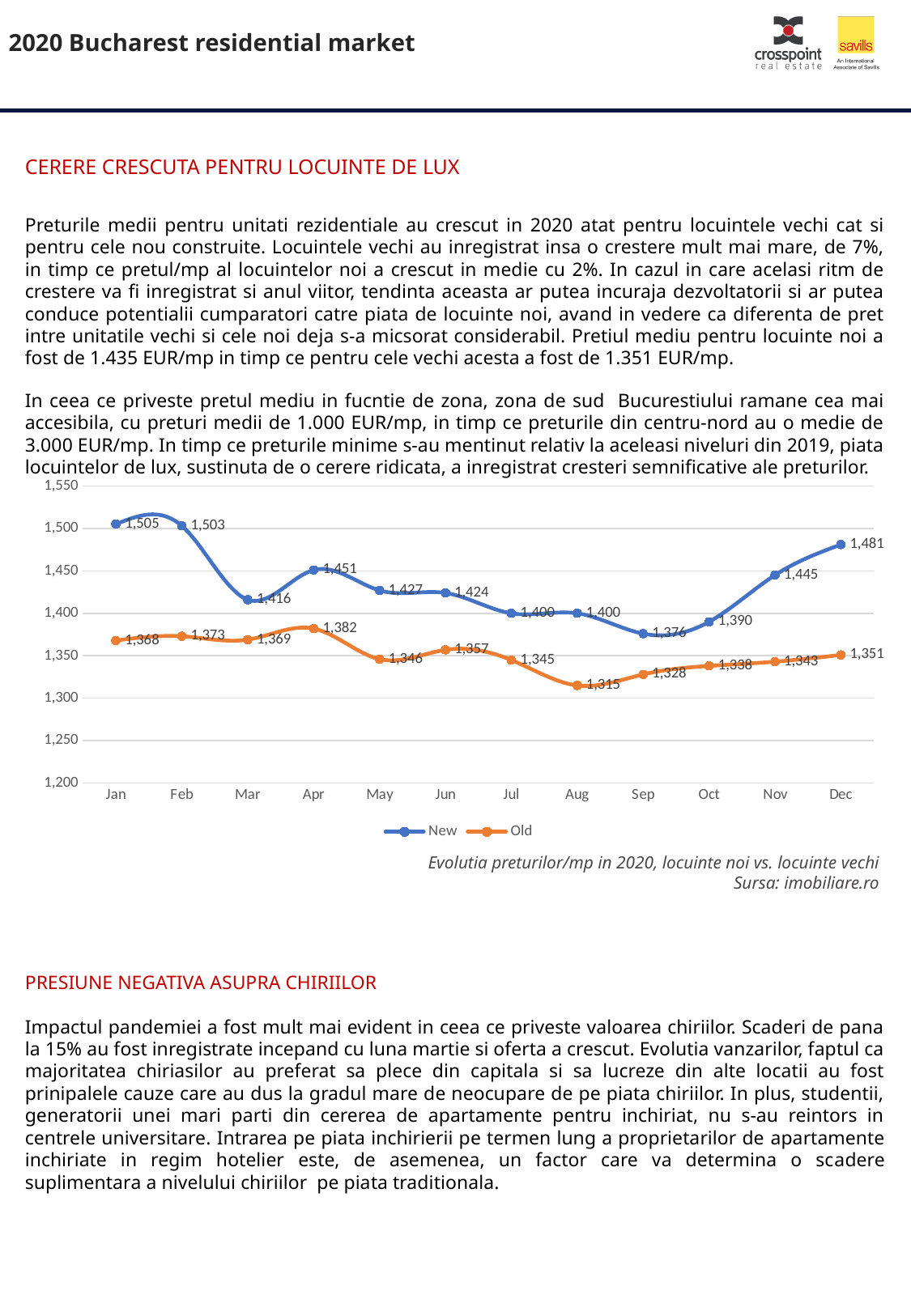
Which is larger, the New value in March or the New value in April? April What kind of chart is shown? Line chart How many series does the legend list? 2 In which month is the Old series at its lowest? Aug What is the value for New in April? 1,451 What is the value for Old in August? 1,315 In which month is the New series at its lowest? Sep How many months are plotted on the x axis? 12 What is the difference between the New and Old values in December? 130 What is the value for Old in December? 1,351 In which month is the New series at its highest? Jan Does the Old series rise or fall from April to August? Fall